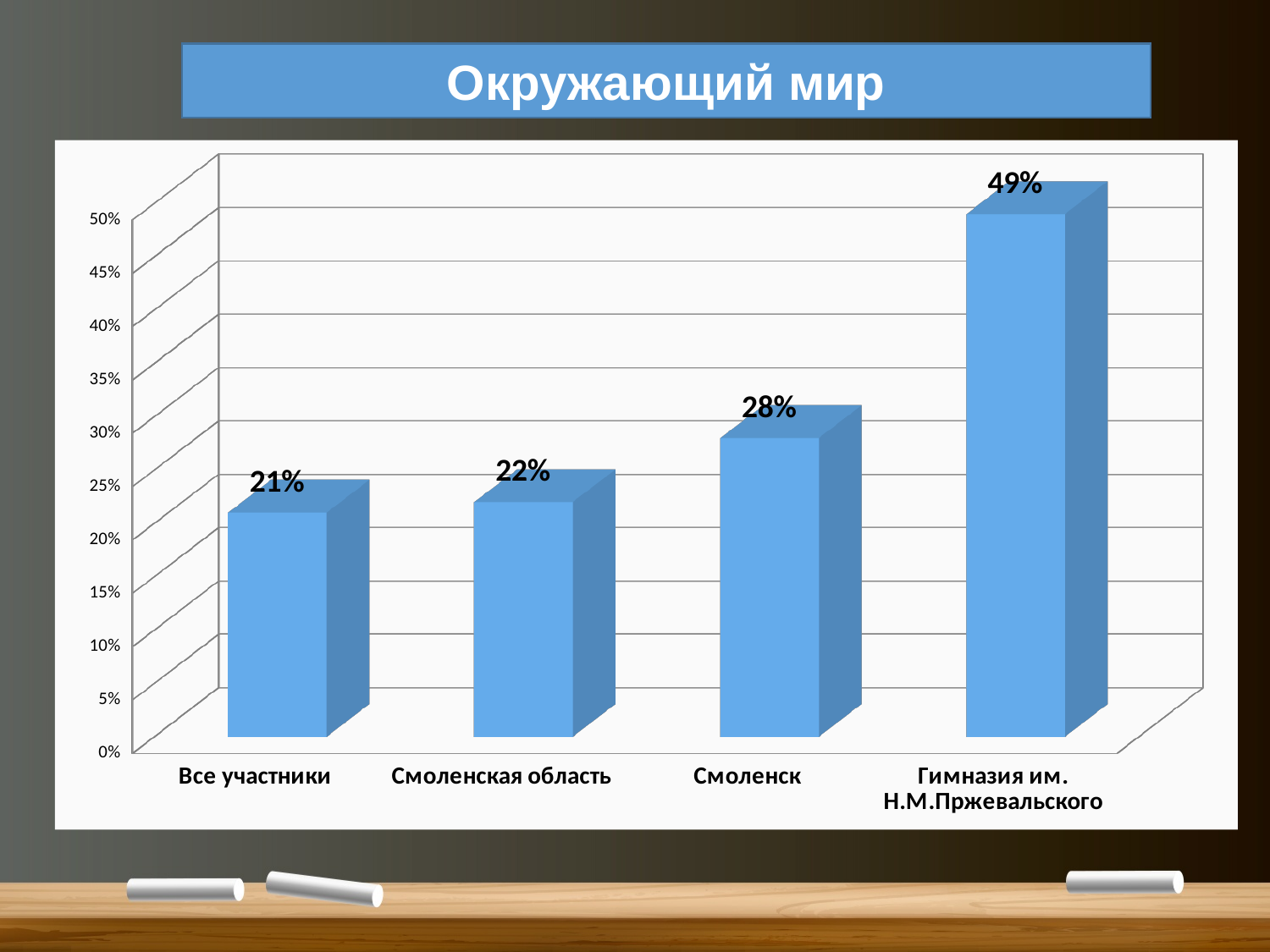
What is the value for Смоленская область? 22% How many categories are shown on the chart? 4 Which category has the lowest value? Все участники Which is larger, the value for Смоленск or the value for Смоленская область? Смоленск What is the value for Все участники? 21% Which category has the highest value? Гимназия им. Н.М.Пржевальского What is the title of the slide? Окружающий мир What is the value for Смоленск? 28% What kind of chart is shown on the slide? bar chart Is the value for Гимназия им. Н.М.Пржевальского greater or less than 40%? greater What is the value for Гимназия им. Н.М.Пржевальского? 49% What is the difference between the values for Гимназия им. Н.М.Пржевальского and Смоленск? 21%